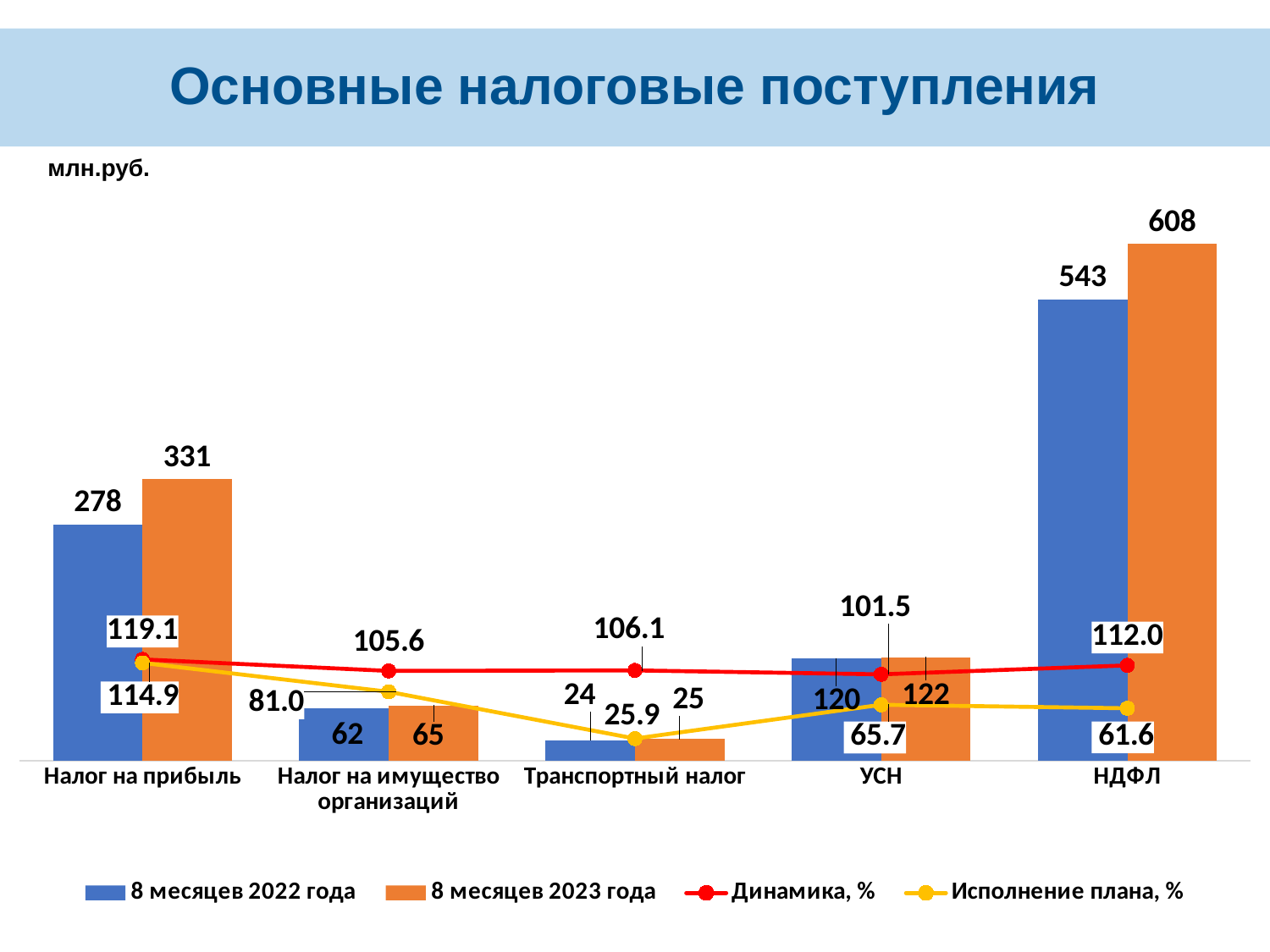
How many series does the legend list? 4 What kind of chart is shown on the slide? Combined bar and line chart What is the value for НДФЛ in the '8 месяцев 2023 года' series? 608 What is the 'Динамика, %' value for Транспортный налог? 106.1 What unit is indicated above the chart? млн.руб. Which is larger for Налог на прибыль: the 2022 value or the 2023 value? 2023 value (331) What is the 'Исполнение плана, %' value for УСН? 65.7 How many tax categories are shown on the x axis? 5 Which category has the highest value in the '8 месяцев 2023 года' series? НДФЛ Which category has the lowest 'Исполнение плана, %' value? Транспортный налог What is the difference between the 2023 and 2022 values for НДФЛ? 65 What is the value for Налог на прибыль in the '8 месяцев 2022 года' series? 278